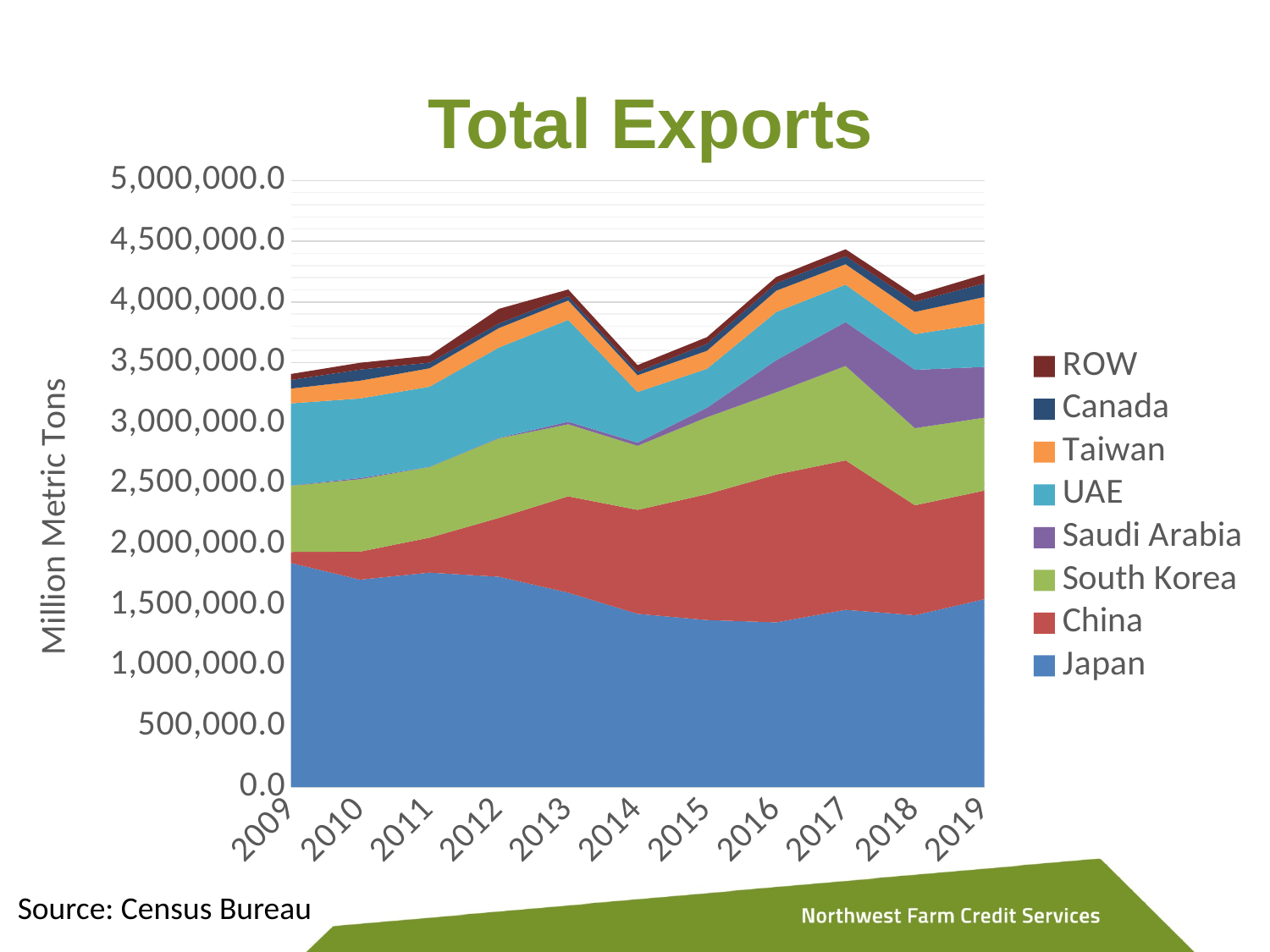
How many years are plotted along the x axis? 11 What is the title of the chart? Total Exports Is the total of all series in 2017 greater or less than 4,000,000.0? greater How many series does the legend list? 8 In 2009, which is larger: the value for Japan or the value for China? Japan Does the value for China rise or fall from 2009 to 2017? Rise Is the value for Japan in 2016 greater or less than 1,500,000.0? less Is the total of all series in 2014 greater or less than 4,000,000.0? less Does the value for Japan rise or fall from 2009 to 2016? Fall What is the label on the y axis? Million Metric Tons What kind of chart is shown on the slide? Stacked area chart